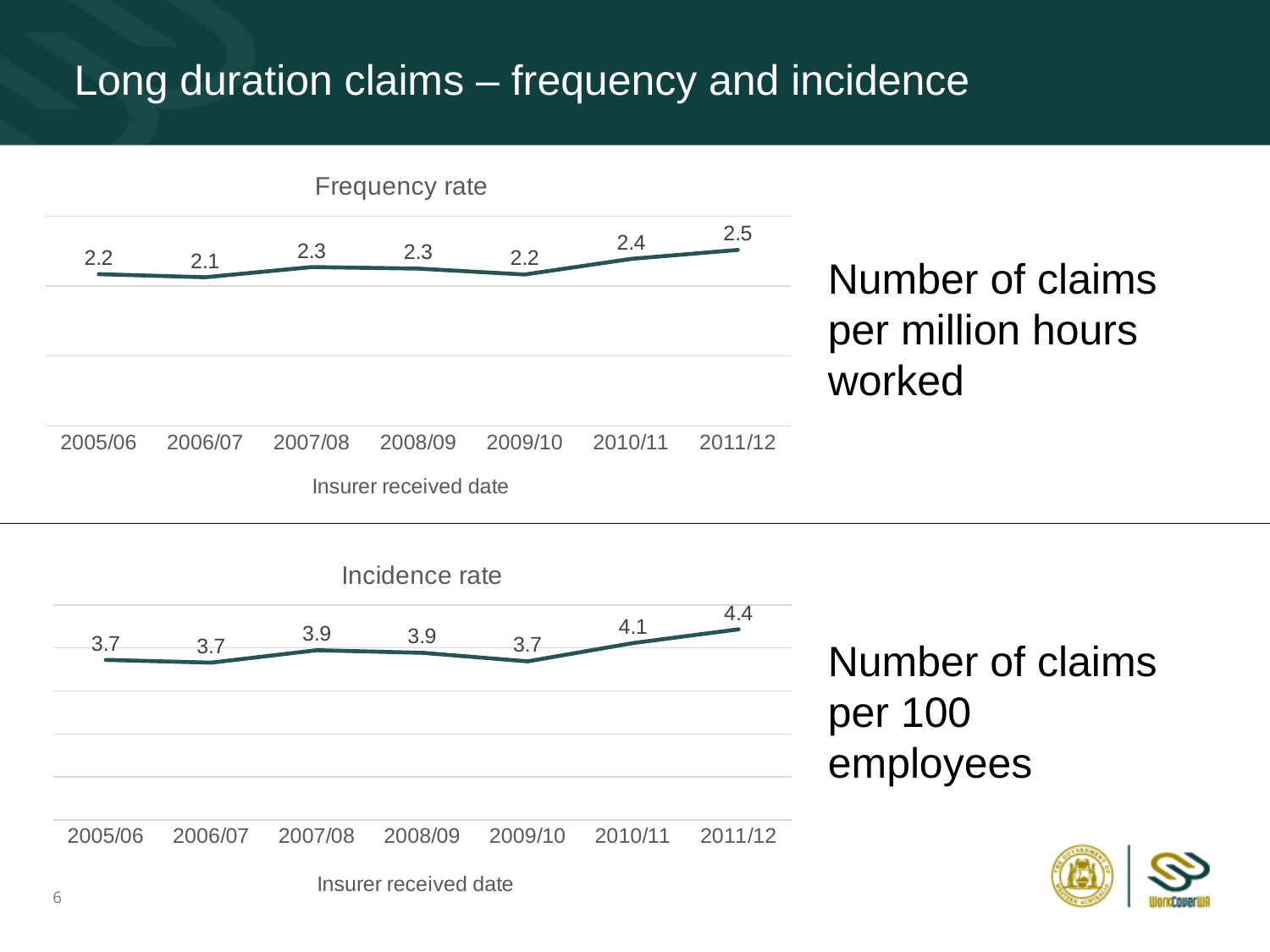
In the Incidence rate chart, which is larger, the value for 2007/08 or the value for 2009/10? 2007/08 What kind of chart is the Incidence rate chart? line chart In the Frequency rate chart, what is the difference between the values for 2010/11 and 2009/10? 0.2 What is the x-axis label of the Frequency rate chart? Insurer received date In the Incidence rate chart, which year has the highest value? 2011/12 In the Frequency rate chart, which year has the lowest value? 2006/07 How many years are plotted in the Frequency rate chart? 7 In the Incidence rate chart, what is the value for 2010/11? 4.1 In the Frequency rate chart, what is the value for 2011/12? 2.5 In the Incidence rate chart, do the values rise or fall from 2009/10 to 2011/12? rise In the Incidence rate chart, what is the difference between the values for 2011/12 and 2005/06? 0.7 In the Frequency rate chart, what is the value for 2006/07? 2.1